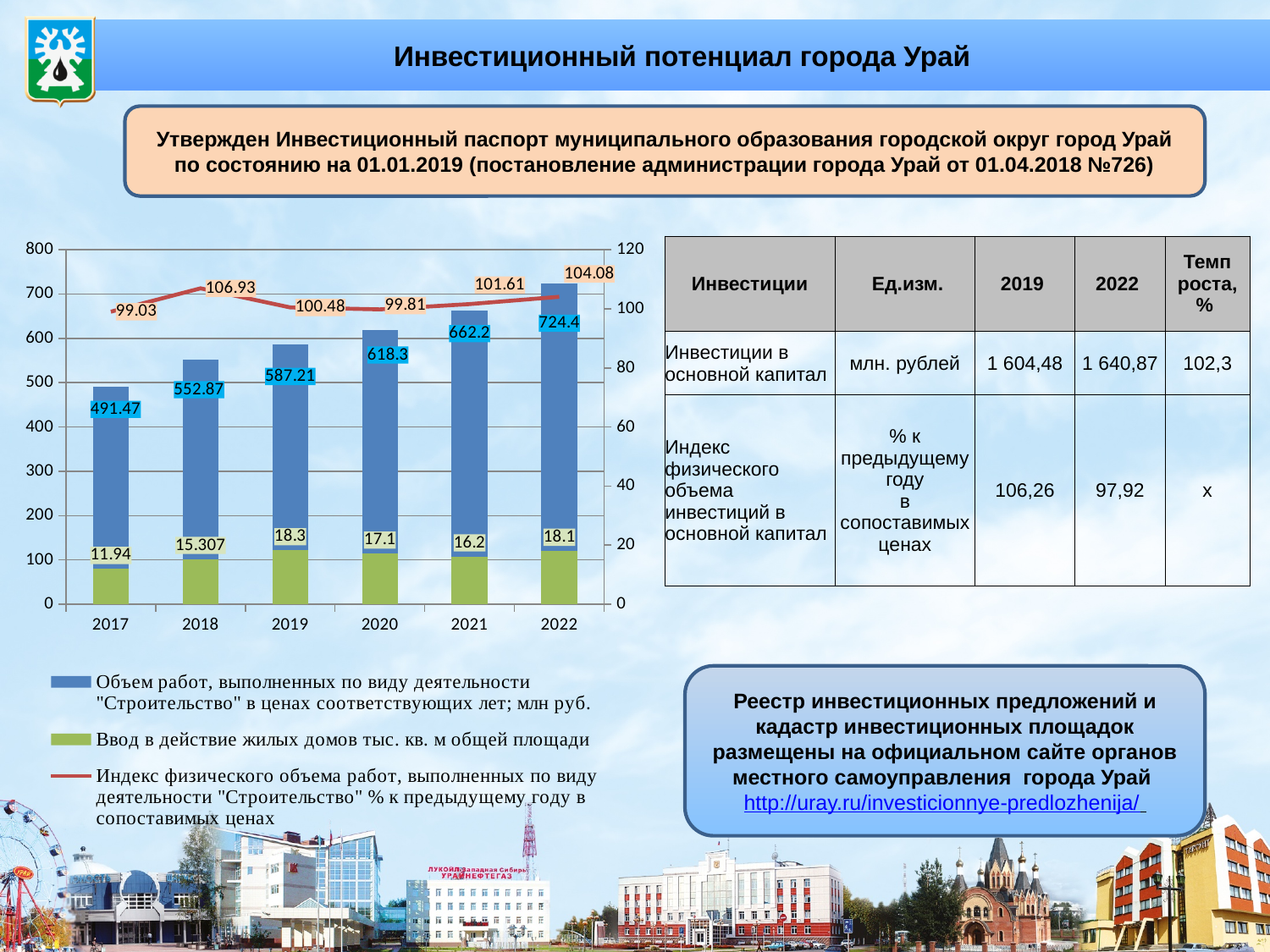
What is the value of the physical volume index (red line) for 2018? 106.93 What is the difference between the construction work volume in 2022 and in 2021? 62.2 In which year is the construction work volume (blue bars) highest? 2022 In which year is the physical volume index (red line) lowest? 2017 What is the value of the construction work volume ("Объем работ... Строительство") for 2022? 724.4 What kind of chart is shown on the slide? Combined bar and line chart What is the value of the construction work volume for 2017? 491.47 What is the value of housing commissioned ("Ввод в действие жилых домов") for 2018? 15.307 How many years are shown on the x axis of the chart? 6 How many series does the chart legend list? 3 Does the construction work volume (blue bars) rise or fall from 2017 to 2022? Rise Which year has a larger housing commissioned value, 2019 or 2020? 2019